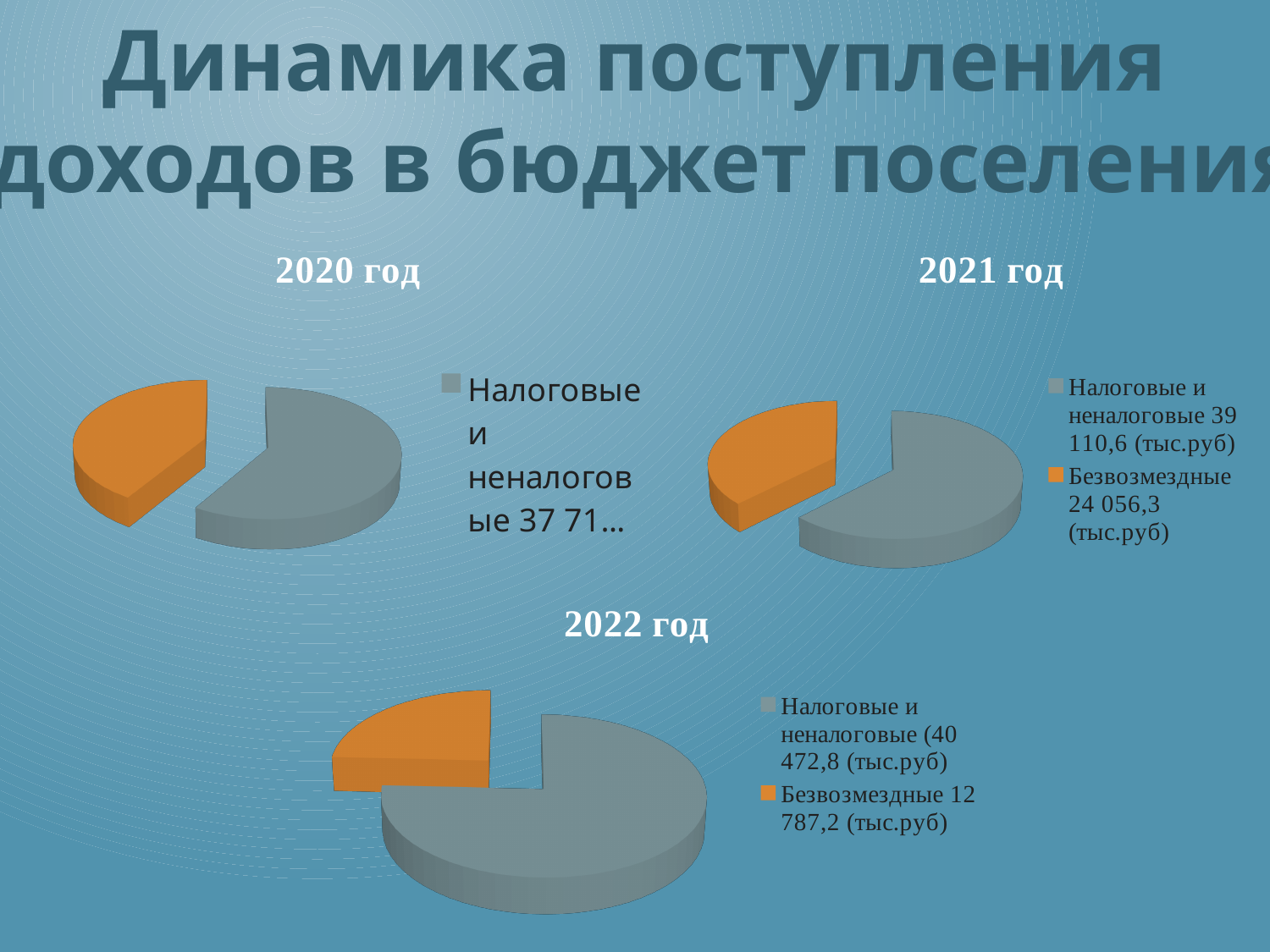
In the 2021 год chart, what is the value for Безвозмездные? 24 056,3 (тыс.руб) In the 2022 год chart, which category has the smallest slice? Безвозмездные In the 2022 год chart, what colour is the Безвозмездные slice? Orange In the 2022 год chart, what is the difference between Налоговые и неналоговые and Безвозмездные? 27 685,6 (тыс.руб) In the 2021 год chart, what is the difference between Налоговые и неналоговые and Безвозмездные? 15 054,3 (тыс.руб) In the 2022 год chart, what is the value for Налоговые и неналоговые? 40 472,8 (тыс.руб) In the 2021 год chart, what is the value for Налоговые и неналоговые? 39 110,6 (тыс.руб) How many entries does the legend of the 2021 год chart list? 2 What kind of chart is used for the 2020 год, 2021 год and 2022 год charts? Pie chart How many charts are shown on the slide? 3 In the 2022 год chart, what is the value for Безвозмездные? 12 787,2 (тыс.руб)